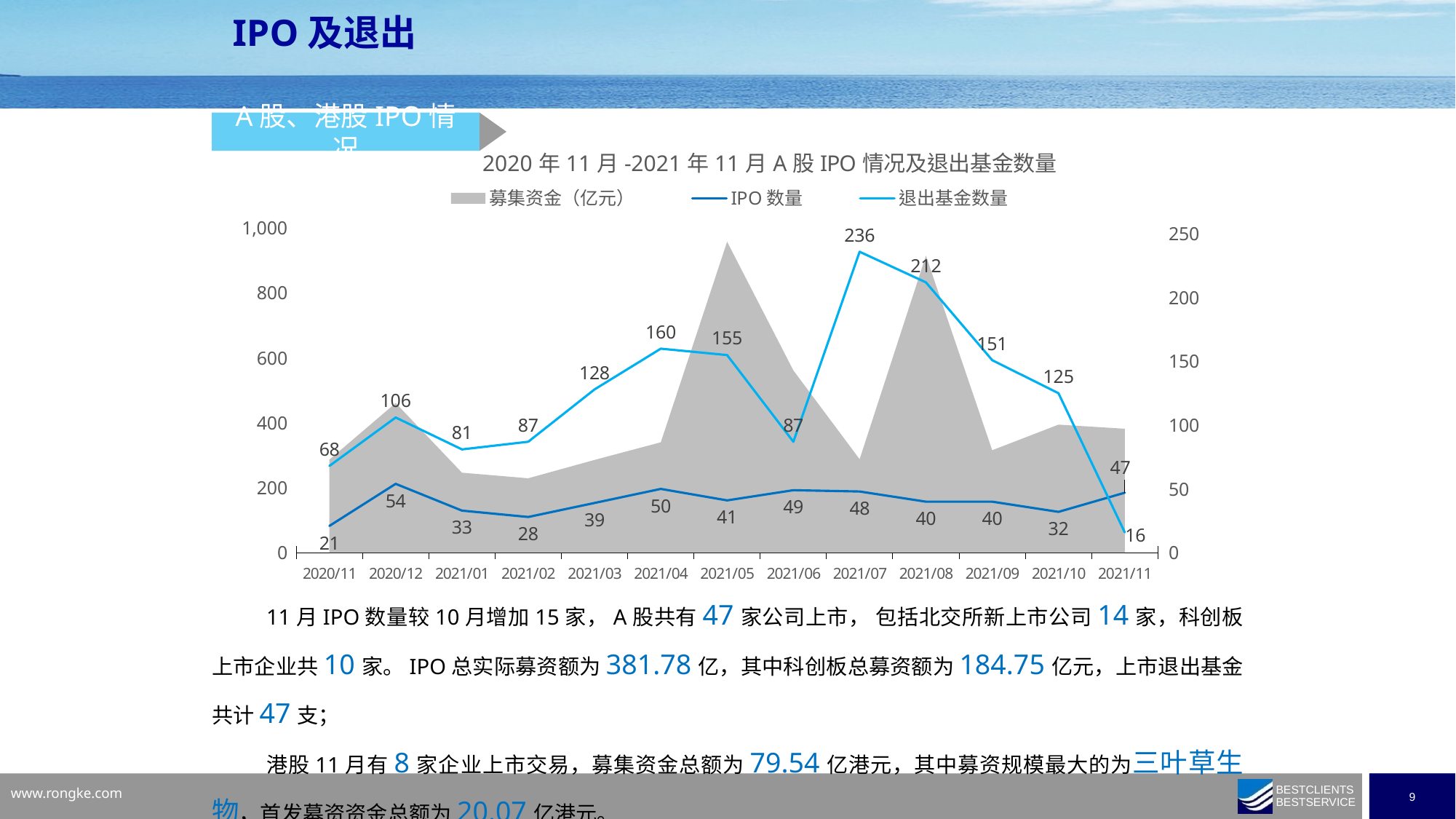
What kind of chart is shown? area and line chart What is the 退出基金数量 value for 2021/07? 236 In which month is 退出基金数量 highest? 2021/07 How many series does the legend list? 3 In which month is 退出基金数量 lowest? 2021/11 Which month has a higher IPO 数量, 2020/12 or 2021/04? 2020/12 What is the IPO 数量 value for 2021/11? 47 In which month is IPO 数量 lowest? 2020/11 Is the 募集资金（亿元） value for 2021/05 greater or less than 800? greater What is the difference between 退出基金数量 in 2021/07 and 2021/08? 24 Does 退出基金数量 rise or fall from 2021/08 to 2021/11? fall How many months are shown on the x axis? 13